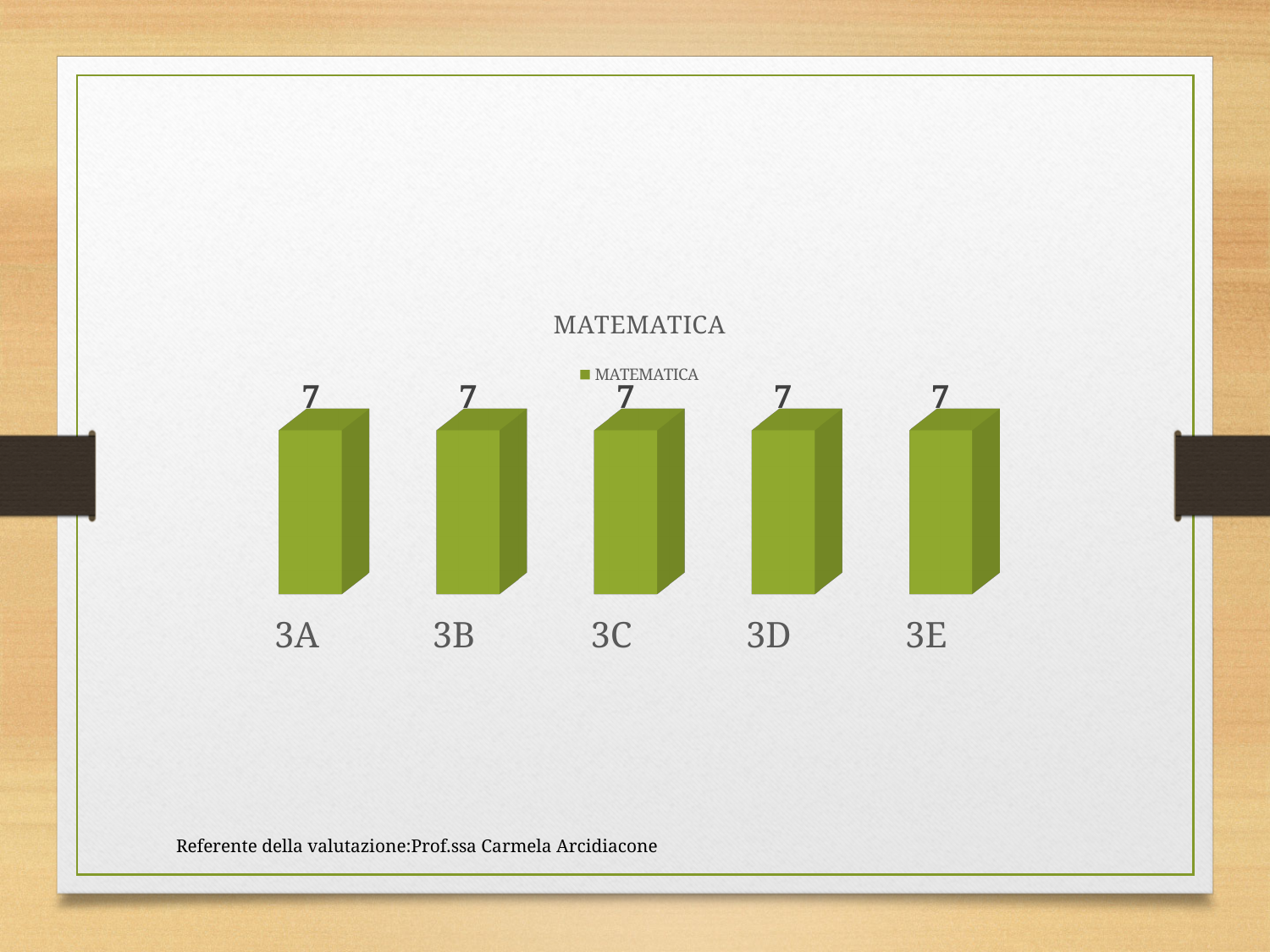
What kind of chart is shown on the slide? bar chart What is the value for 3A? 7 What is the title of the chart? MATEMATICA How many series does the legend list? 1 What is the value for 3B? 7 What series name is shown in the legend? MATEMATICA Do the values rise, fall, or stay the same from 3A to 3E? stay the same What is the value for 3E? 7 What is the value for 3C? 7 How many categories are shown on the x axis? 5 What is the value for 3D? 7 What is the difference between the values for 3A and 3E? 0